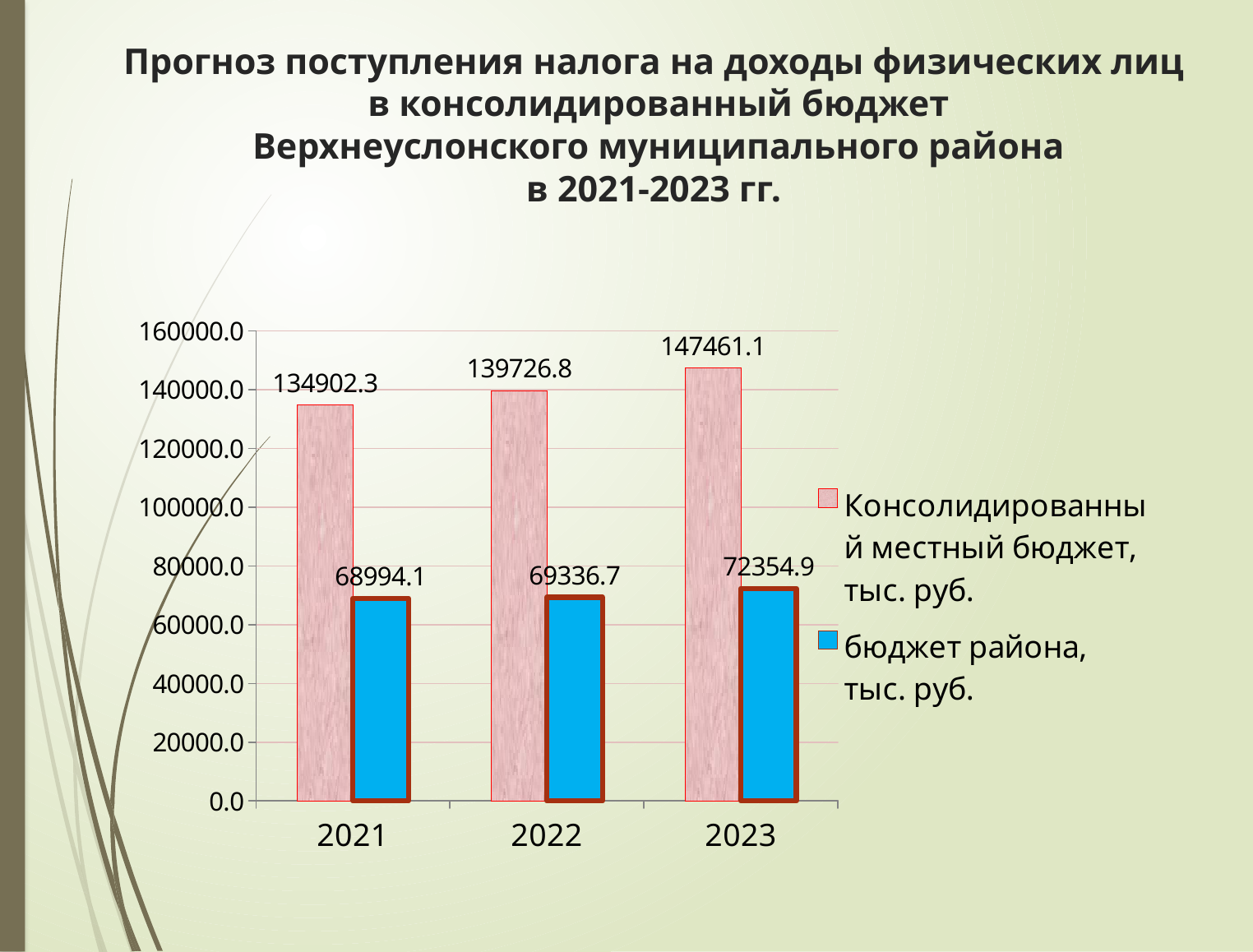
What is the value for the district budget (бюджет района) in 2023? 72354.9 What is the difference between the consolidated local budget and the district budget in 2021? 65908.2 Do the consolidated local budget values rise or fall from 2021 to 2023? rise Which is larger in 2022: the consolidated local budget or the district budget? Консолидированный местный бюджет Is the district budget value for 2023 greater or less than 80000.0? less What is the value for the consolidated local budget in 2022? 139726.8 In which year is the district budget value the lowest? 2021 In which year is the consolidated local budget value the highest? 2023 How many series does the legend list? 2 What is the difference between the consolidated local budget values for 2023 and 2021? 12558.8 How many years are shown on the x axis? 3 What is the value for the consolidated local budget (Консолидированный местный бюджет) in 2021? 134902.3